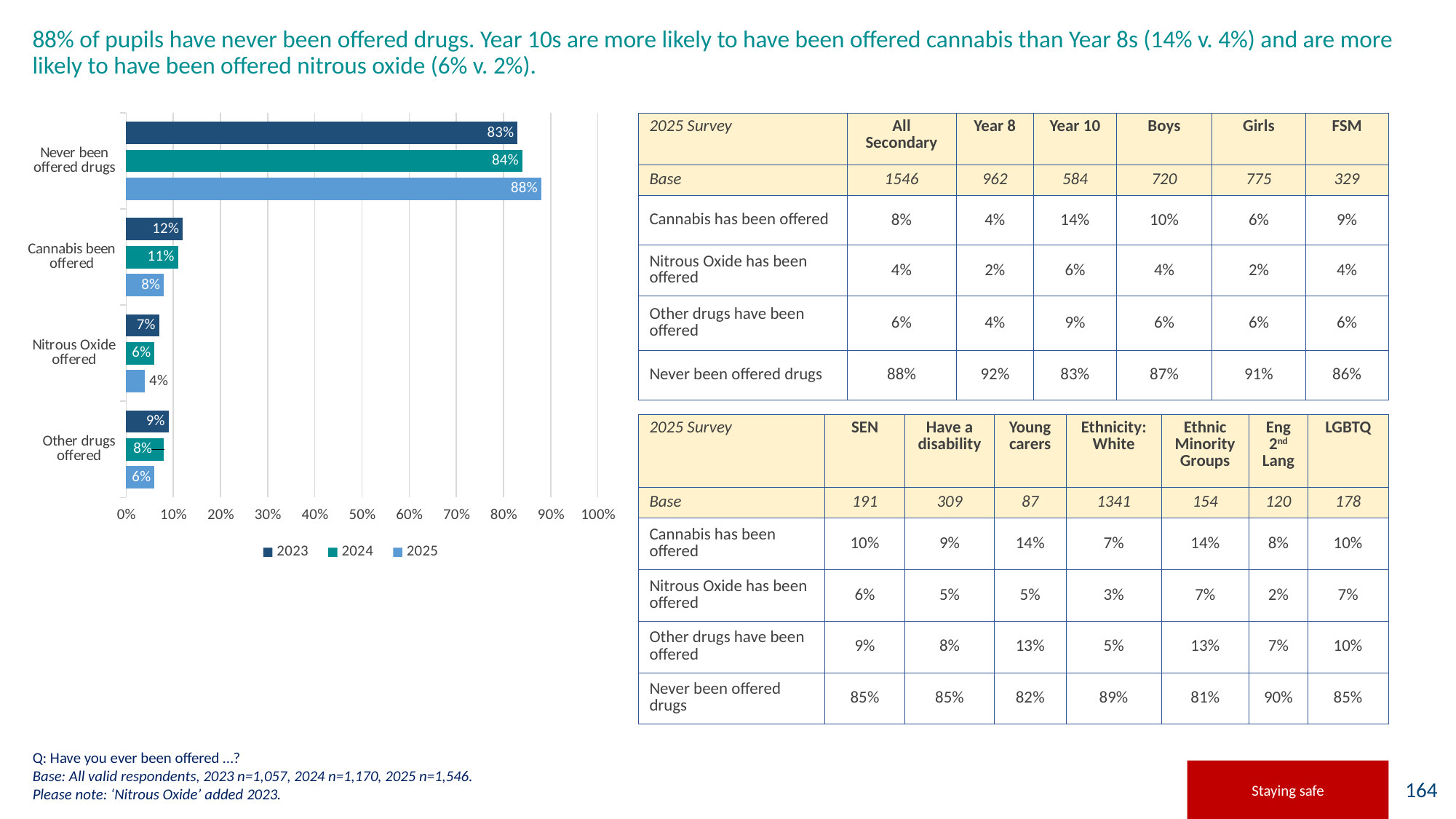
In the bar chart, is the 2023 value for 'Cannabis been offered' larger or smaller than the 2025 value? larger What is the 2025 value for 'Never been offered drugs' in the bar chart? 88% Which category has the highest 2025 value in the bar chart? Never been offered drugs What is the 2025 value for 'Other drugs offered' in the bar chart? 6% How many series does the bar chart legend list? 3 What is the difference between the 2025 and 2023 values for 'Never been offered drugs' in the bar chart? 5 percentage points What is the 2024 value for 'Nitrous Oxide offered' in the bar chart? 6% How many categories are shown on the bar chart? 4 What is the 2023 value for 'Cannabis been offered' in the bar chart? 12% What kind of chart is shown on the slide? bar chart Which category has the lowest 2025 value in the bar chart? Nitrous Oxide offered Which series in the bar chart is shown in light blue? 2025